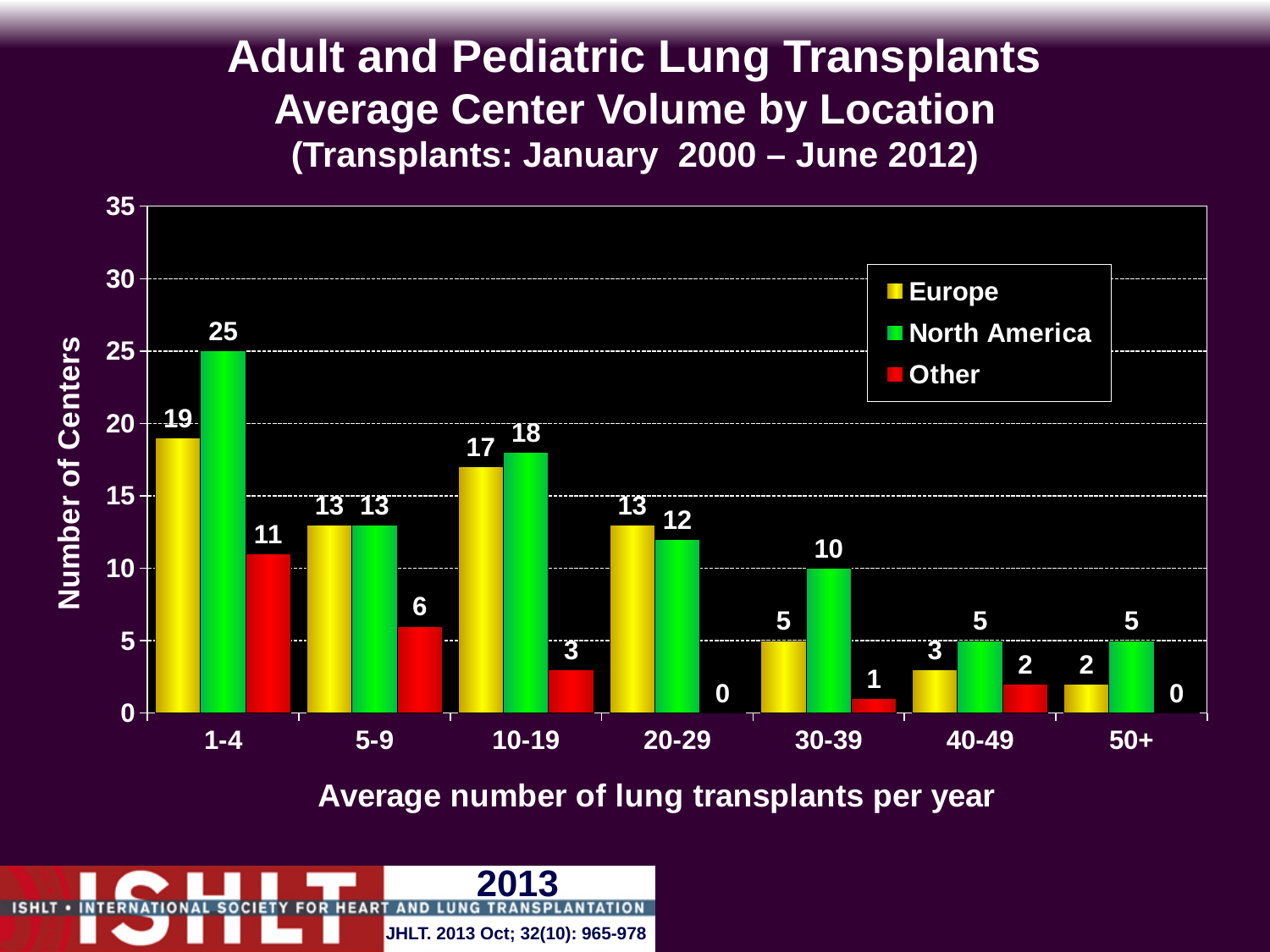
What is the label of the y axis? Number of Centers Which category has the lowest number of Europe centers? 50+ What is the number of centers in North America in the 10-19 transplants per year category? 18 Do the values for the Other series generally rise or fall from the 1-4 category to the 50+ category? Fall What type of chart is shown on the slide? Bar chart How many centers in the Other region fall in the 5-9 transplants per year category? 6 In the 30-39 category, which region has more centers, Europe or North America? North America Which transplant volume category has the highest number of North America centers? 1-4 How many centers in Europe have an average of 1-4 lung transplants per year? 19 How many series does the legend list? 3 How many volume categories are shown on the x axis? 7 What is the difference between the North America and Europe values in the 1-4 category? 6